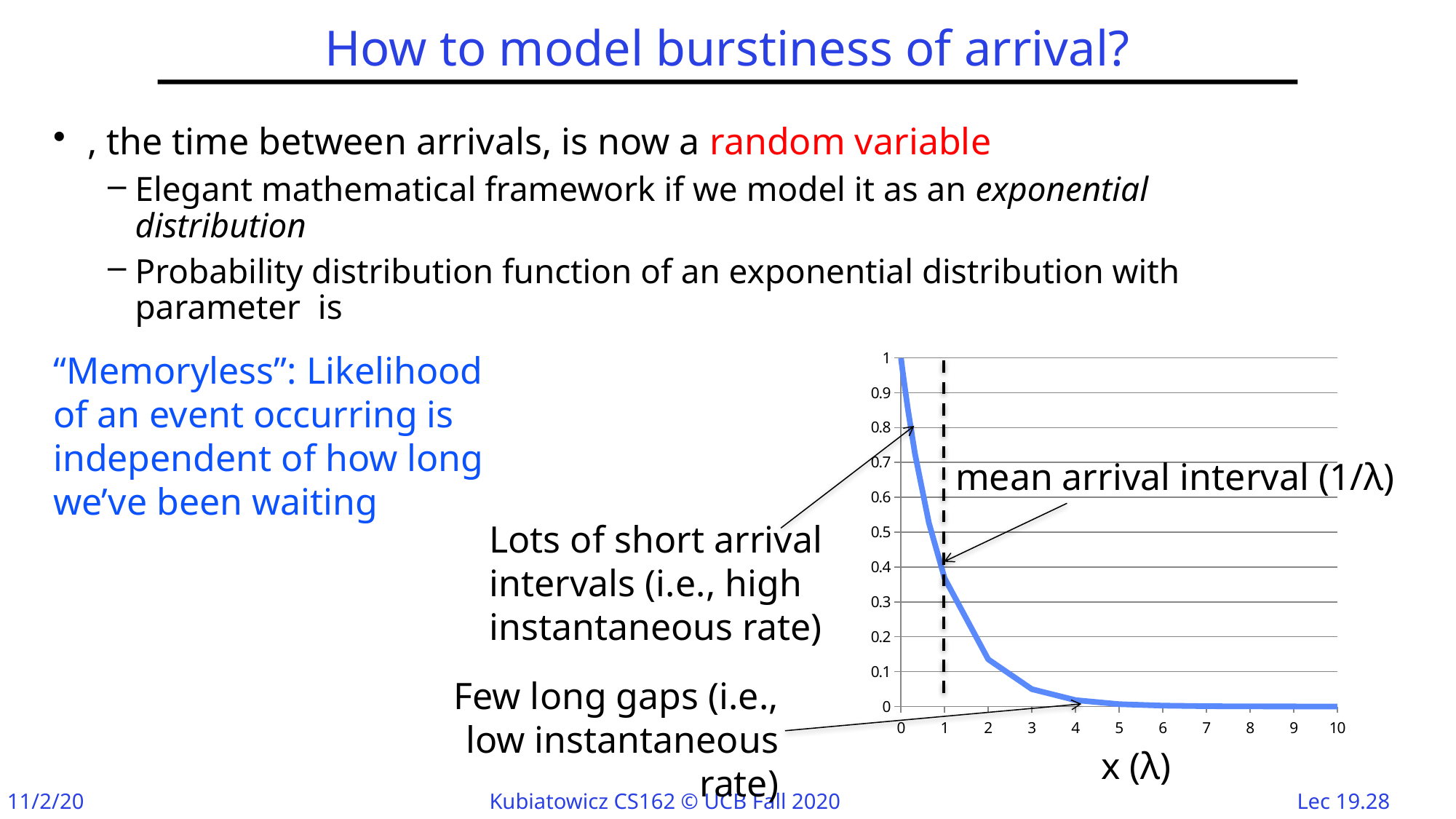
At which x value is the dashed vertical line marking the mean arrival interval (1/λ) drawn? 1 How many tick labels are shown on the x axis? 11 Is the value of the curve at x = 4 greater or less than 0.1? less Is the value of the curve at x = 1 greater or less than 0.5? less Do the plotted values rise or fall as x increases along the x axis? fall What is the label on the x axis of the chart? x (λ) Which is larger, the value of the curve at x = 1 or at x = 3? x = 1 What is the value of the curve at x = 0? 1 Is the value of the curve at x = 1 greater or less than 0.3? greater What kind of chart is shown on the slide? line chart At which x value does the plotted curve reach its highest point? 0